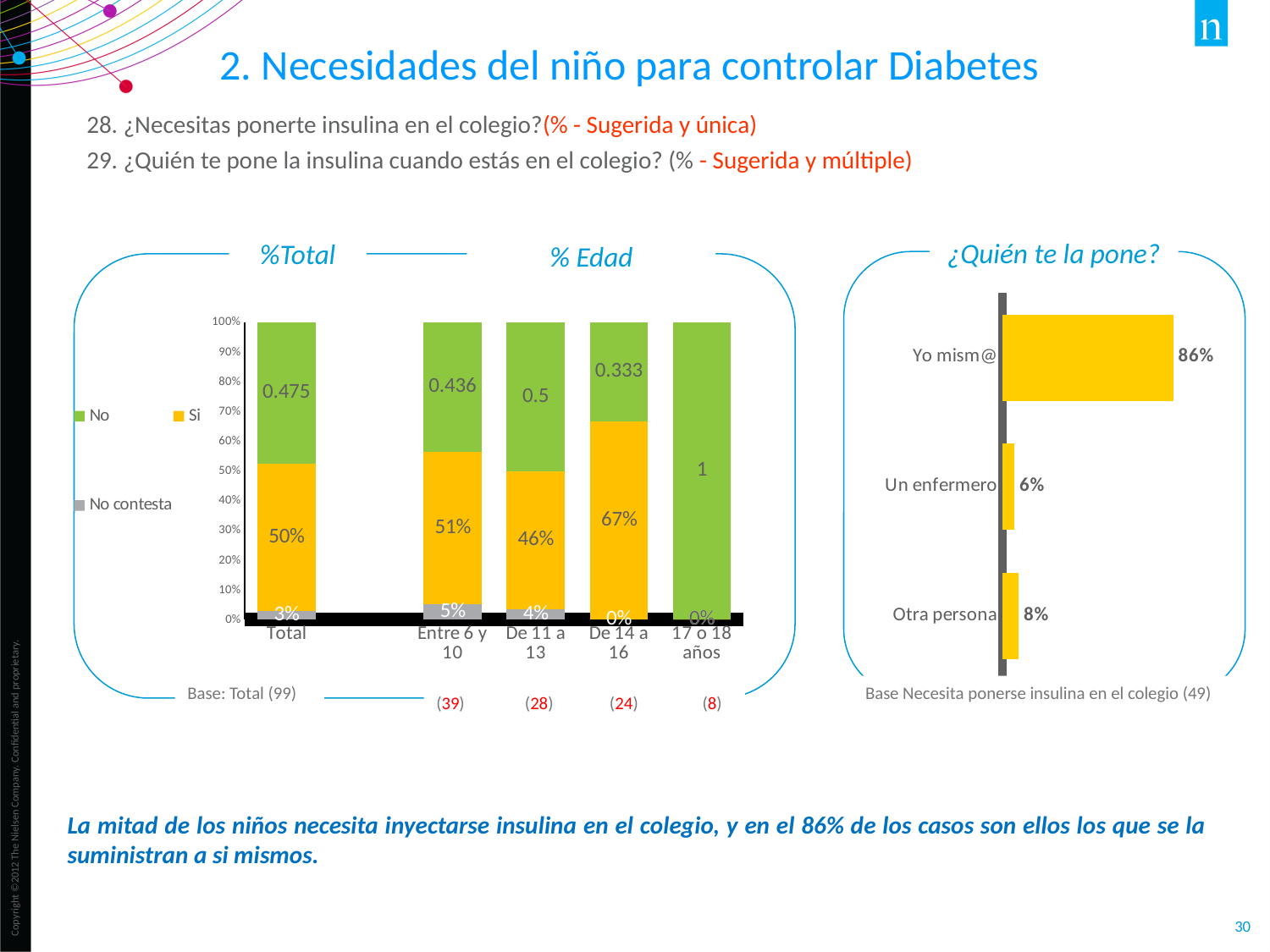
In the '¿Quién te la pone?' chart, what is the value for 'Un enfermero'? 6% In the '¿Quién te la pone?' chart, what is the difference between 'Otra persona' and 'Un enfermero'? 2% How many series does the legend of the stacked bar chart on the left list? 3 In the '¿Quién te la pone?' chart, how many categories are shown? 3 In the stacked bar chart on the left, what is the 'No' value for 'Entre 6 y 10'? 0.436 In the stacked bar chart on the left, what is the 'No contesta' value for 'Total'? 3% In the '¿Quién te la pone?' chart, what is the value for 'Yo mism@'? 86% In the stacked bar chart on the left, which category has the highest 'Si' value? De 14 a 16 What kind of chart is the '¿Quién te la pone?' chart? Bar chart In the stacked bar chart on the left, is the 'Si' value larger for 'Entre 6 y 10' or for 'De 11 a 13'? Entre 6 y 10 In the '¿Quién te la pone?' chart, which category has the lowest value? Un enfermero In the stacked bar chart on the left, what is the 'Si' value for 'De 14 a 16'? 67%